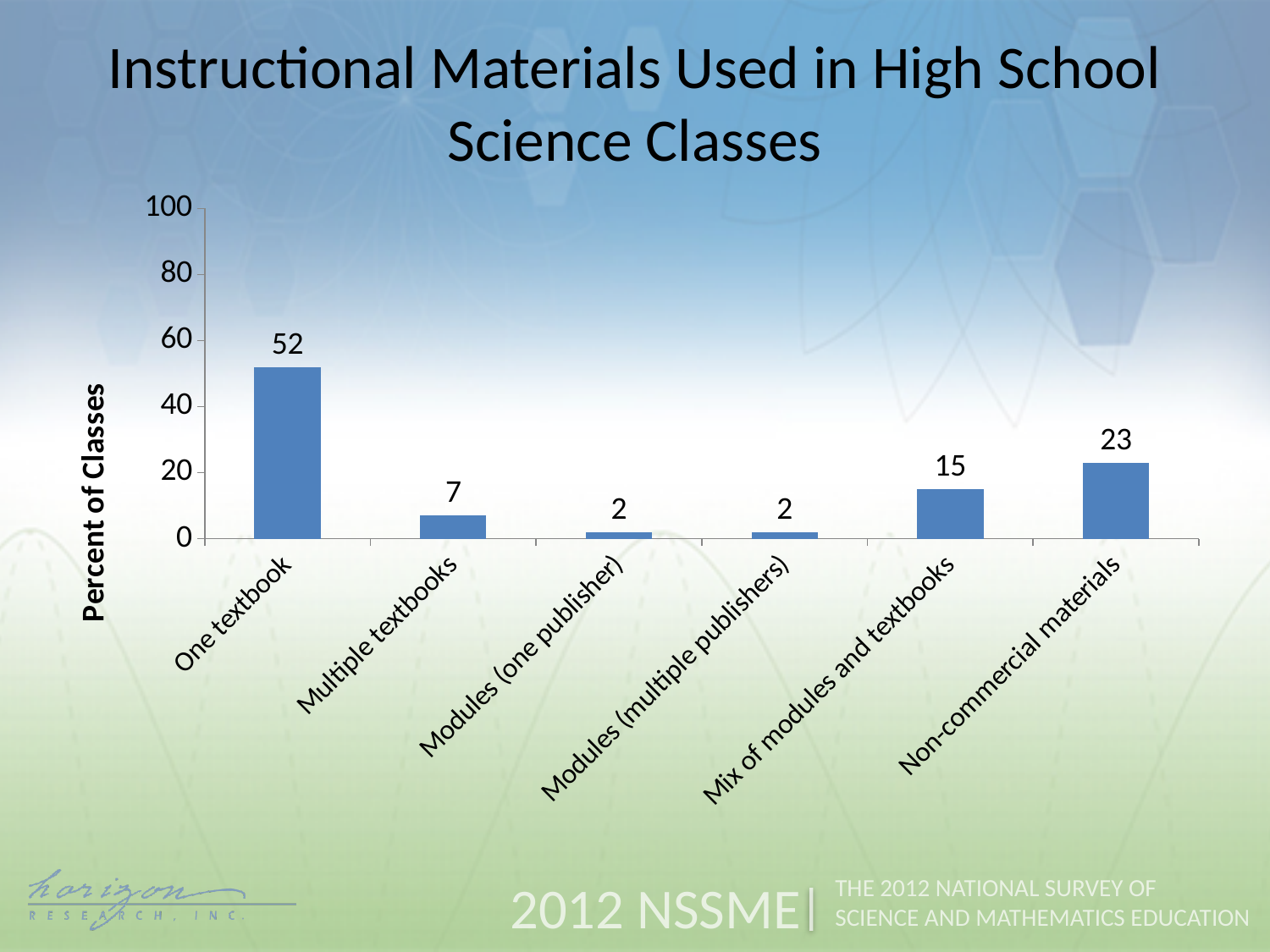
What is the label of the y axis? Percent of Classes What is the value for Multiple textbooks? 7 What percent of classes use one textbook? 52 What kind of chart is shown on the slide? Bar chart What is the value for Non-commercial materials? 23 Is the value for One textbook greater or less than 40? greater What is the value for Mix of modules and textbooks? 15 What is the difference between the values for One textbook and Non-commercial materials? 29 What is the difference between the values for Mix of modules and textbooks and Multiple textbooks? 8 Which is larger, the value for Non-commercial materials or the value for Mix of modules and textbooks? Non-commercial materials How many categories are shown on the x axis? 6 Which category has the highest percent of classes? One textbook